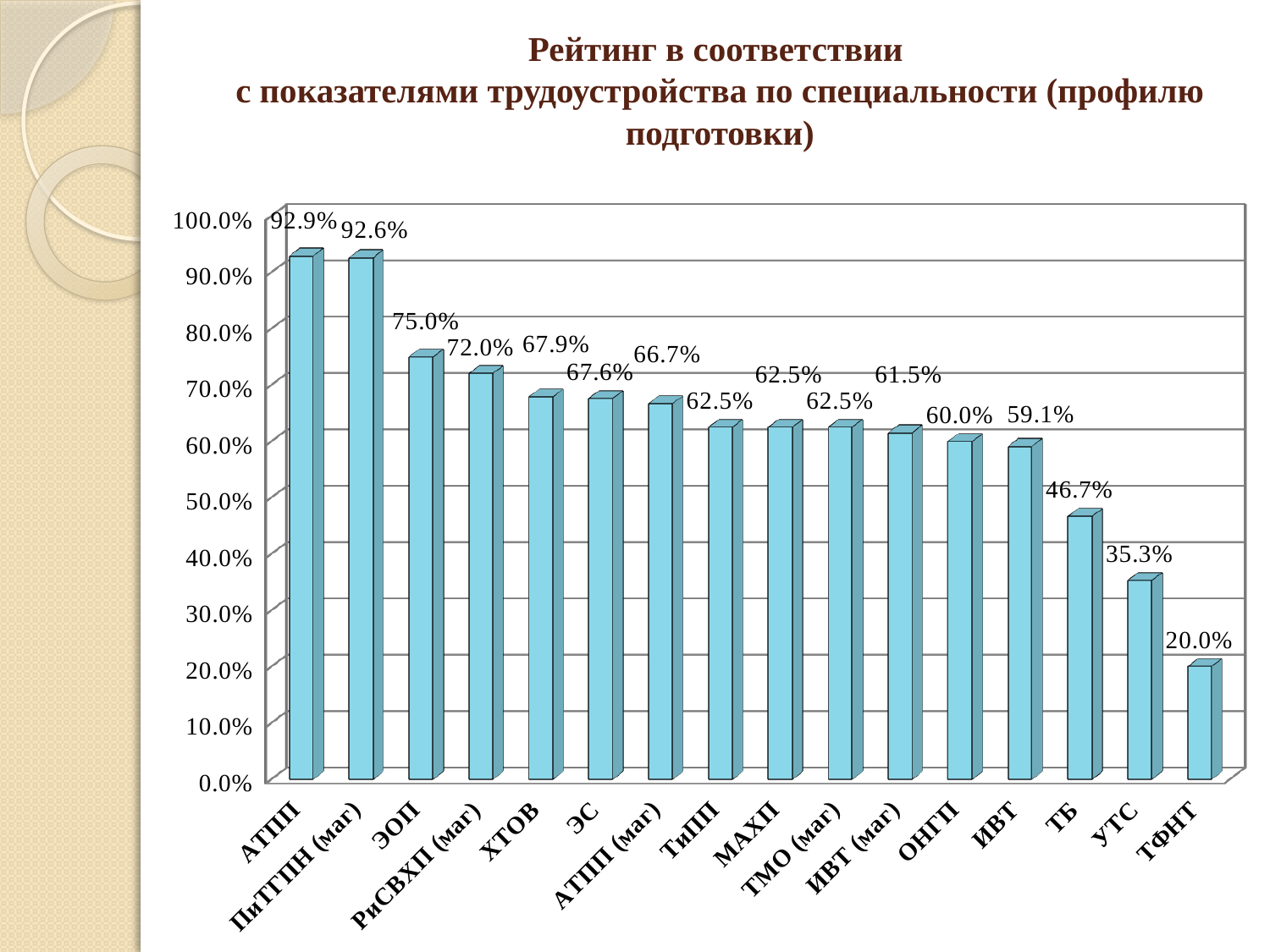
How many categories (specialties) are plotted on the chart? 16 What is the difference between the values for ЭОП and ТФНТ? 55.0 percentage points What is the value for УТС? 35.3% What is the difference between the values for ТБ and УТС? 11.4 percentage points Do the values rise or fall from left to right along the x axis? Fall What is the value for ТБ? 46.7% Which is larger, the value for ХТОВ or the value for ОНГП? ХТОВ What is the value for ЭОП? 75.0% Which category has the lowest value? ТФНТ What kind of chart is shown on the slide? Bar chart Which category has the highest value? АТПП What is the value for ИВТ (маг)? 61.5%